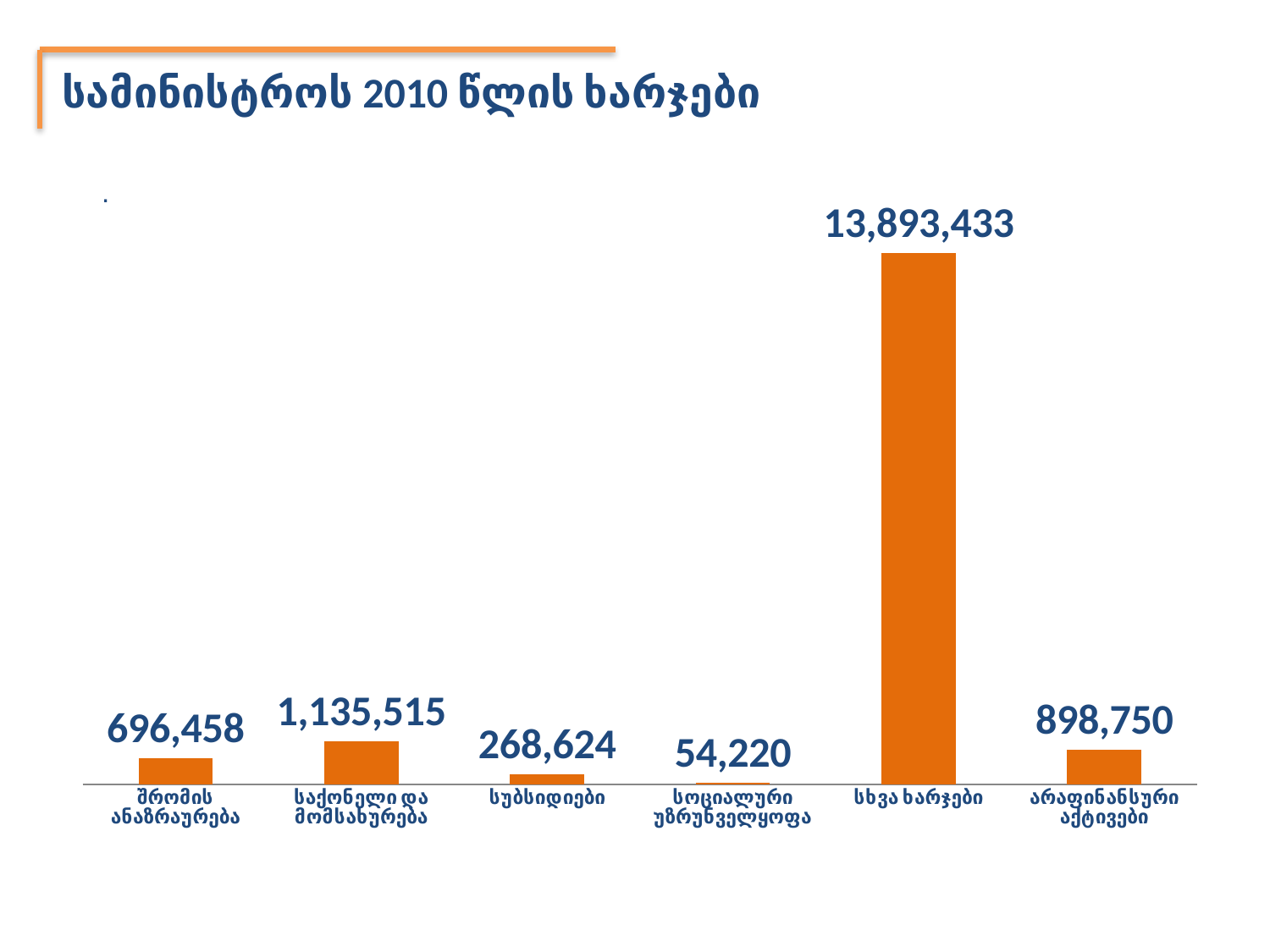
What is the difference between საქონელი და მომსახურება and შრომის ანაზღაურება? 439,057 Which is larger, არაფინანსური აქტივები or შრომის ანაზღაურება? არაფინანსური აქტივები What is the value for საქონელი და მომსახურება? 1,135,515 Which category has the highest value? სხვა ხარჯები What is the difference between სუბსიდიები and სოციალური უზრუნველყოფა? 214,404 What is the title of the slide? სამინისტროს 2010 წლის ხარჯები Which category has the lowest value? სოციალური უზრუნველყოფა What kind of chart is shown on the slide? Bar chart What is the value for შრომის ანაზღაურება? 696,458 What is the value for სოციალური უზრუნველყოფა? 54,220 What is the value for არაფინანსური აქტივები? 898,750 How many categories are shown in the chart? 6